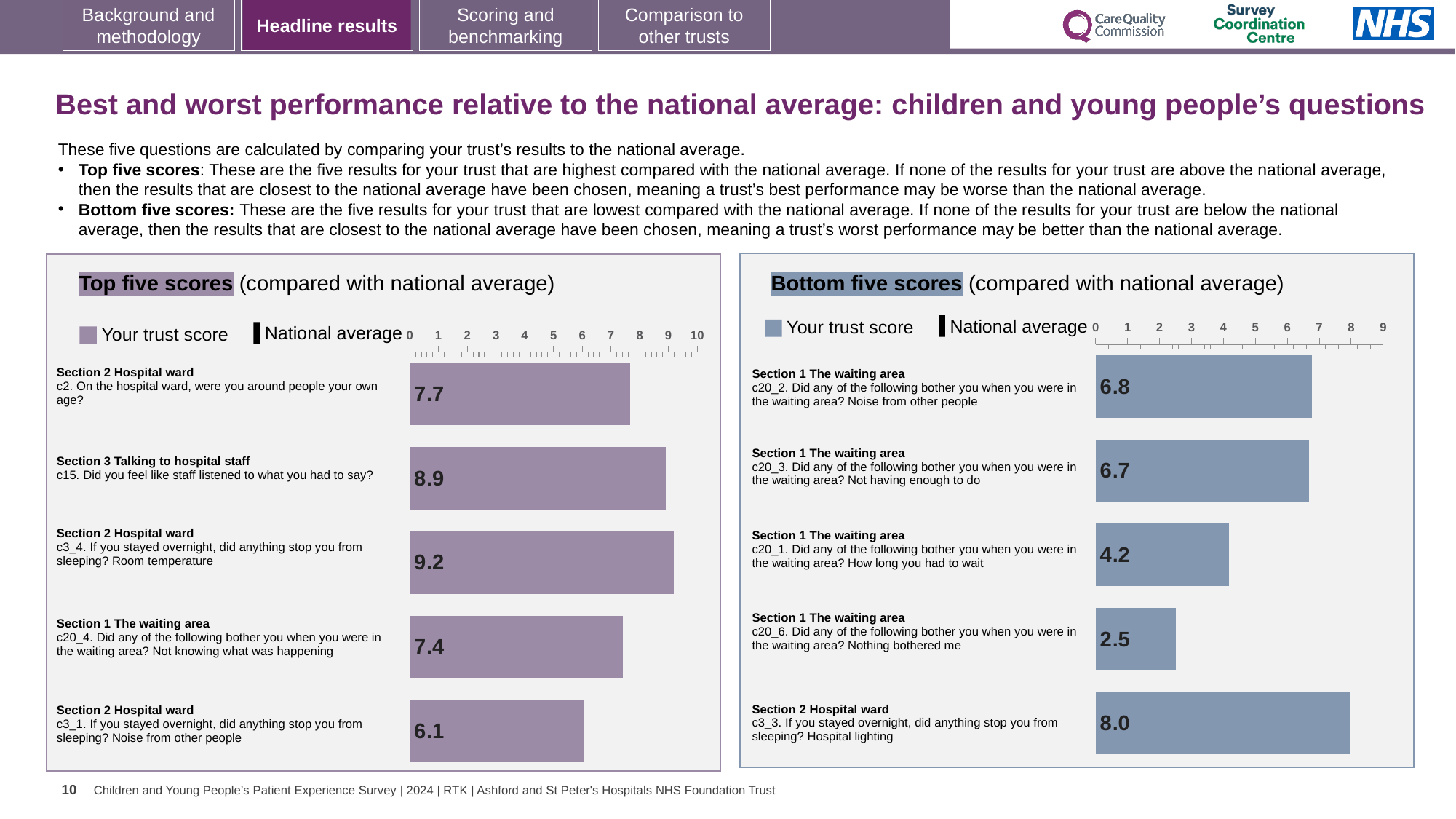
In the Top five scores chart, what is the trust score for c15 (Did you feel like staff listened to what you had to say?)? 8.9 How many questions are shown in the Bottom five scores chart? 5 What type of chart is the Top five scores chart? Bar chart In the Top five scores chart, which question has the highest trust score? c3_4. Room temperature In the Bottom five scores chart, what is the trust score for c3_3 (Hospital lighting stopping you sleeping)? 8.0 How many entries does the legend of the Bottom five scores chart list? 2 In the Top five scores chart, what is the difference between the trust scores for c3_4 (9.2) and c3_1 (6.1)? 3.1 In the Top five scores chart, what is the trust score for c3_1 (Noise from other people stopping you sleeping)? 6.1 In the Top five scores chart, which has the larger trust score: c2 (around people your own age) or c20_4 (not knowing what was happening)? c2 In the Bottom five scores chart, which question has the lowest trust score? c20_6. Nothing bothered me In the Bottom five scores chart, what is the trust score for c20_6 (Nothing bothered me in the waiting area)? 2.5 In the Bottom five scores chart, what is the difference between the trust scores for c3_3 (8.0) and c20_1 (4.2)? 3.8